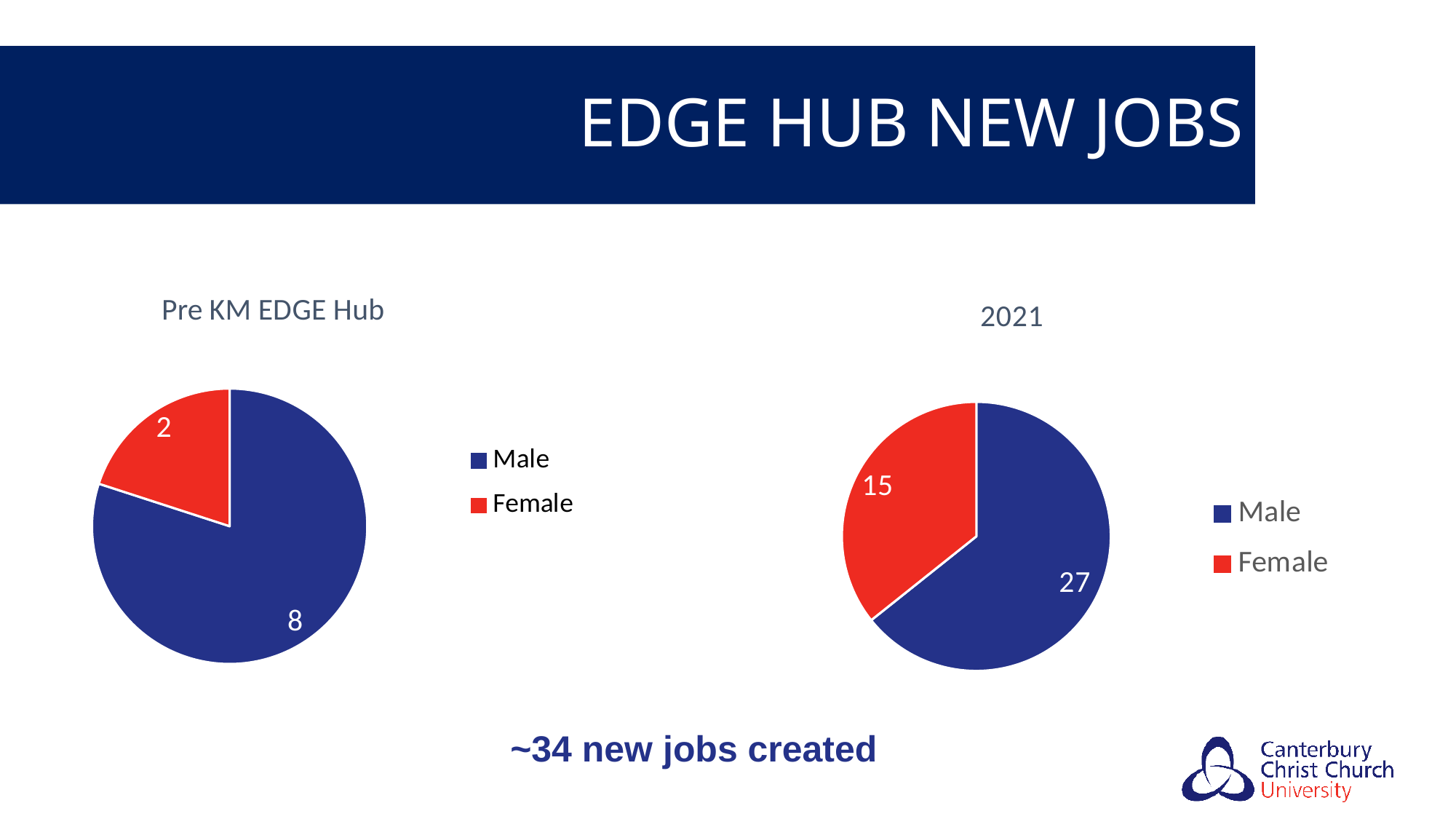
In the '2021' pie chart, what is the value for Male? 27 In the 'Pre KM EDGE Hub' pie chart, which category has the smallest slice? Female How many slices does the '2021' pie chart have? 2 In the '2021' pie chart, what is the difference between the Male and Female values? 12 In the '2021' pie chart, which category has the largest slice? Male In the 'Pre KM EDGE Hub' pie chart, what is the value for Female? 2 How many series does the legend of the 'Pre KM EDGE Hub' chart list? 2 In the 'Pre KM EDGE Hub' pie chart, what is the difference between the Male and Female values? 6 What type of chart is the '2021' chart? Pie chart In the 'Pre KM EDGE Hub' pie chart, what is the value for Male? 8 In the '2021' pie chart, what is the value for Female? 15 Is the Female value larger in the 'Pre KM EDGE Hub' chart or the '2021' chart? 2021